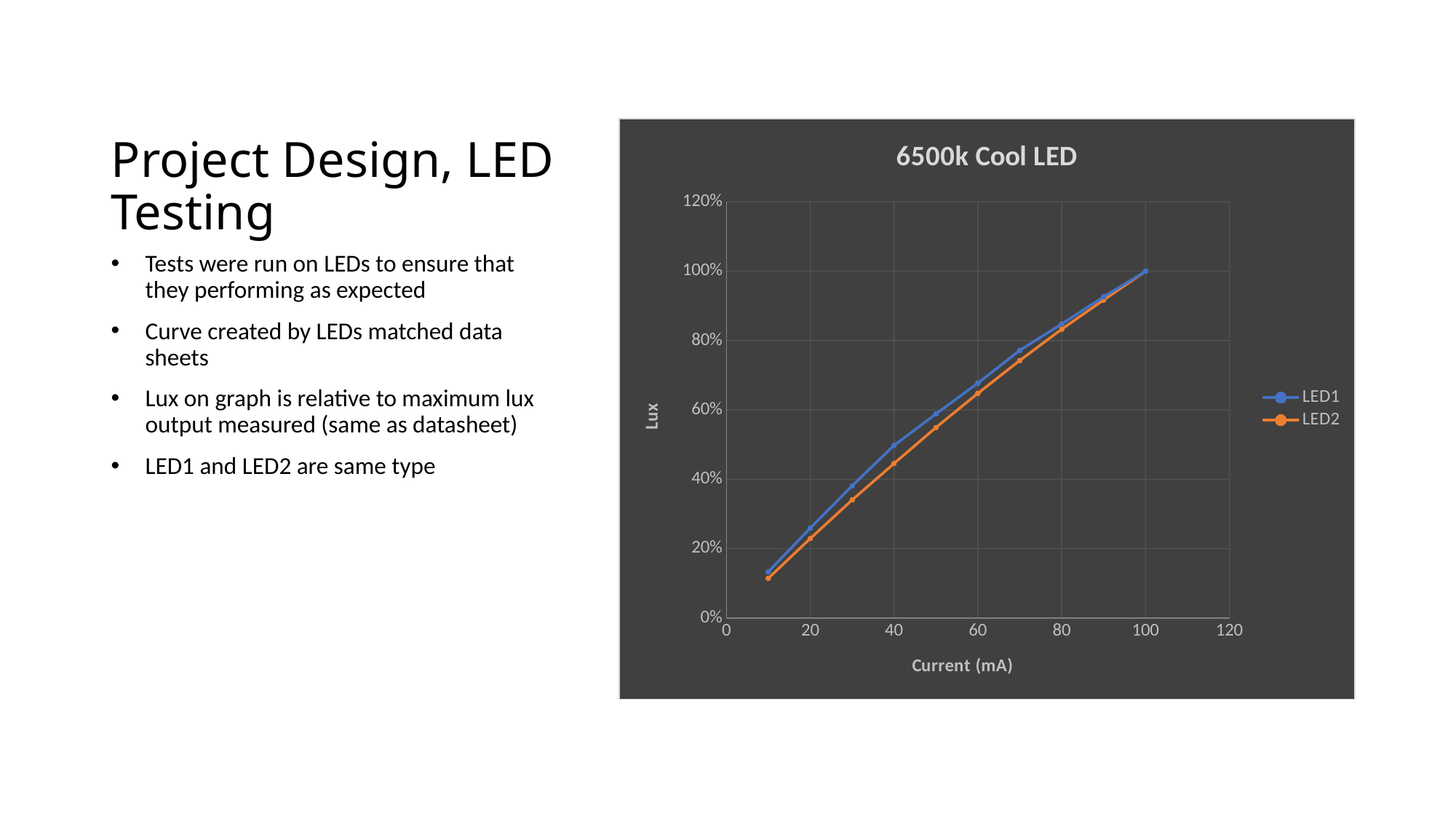
Is the Lux value for LED2 at 40 mA greater or less than 60%? less How many series does the legend list? 2 Is the Lux value for LED1 at 20 mA greater or less than 20%? greater At 40 mA, which series has the higher Lux value, LED1 or LED2? LED1 What is the title of the chart? 6500k Cool LED Is the Lux value for LED2 at 10 mA greater or less than 20%? less Do the Lux values rise or fall as current increases along the x axis? rise What is the Lux value for LED1 at 100 mA? 100% How many data points are plotted for the LED1 series? 10 What is the label of the x axis? Current (mA) What kind of chart is shown on the slide? line chart